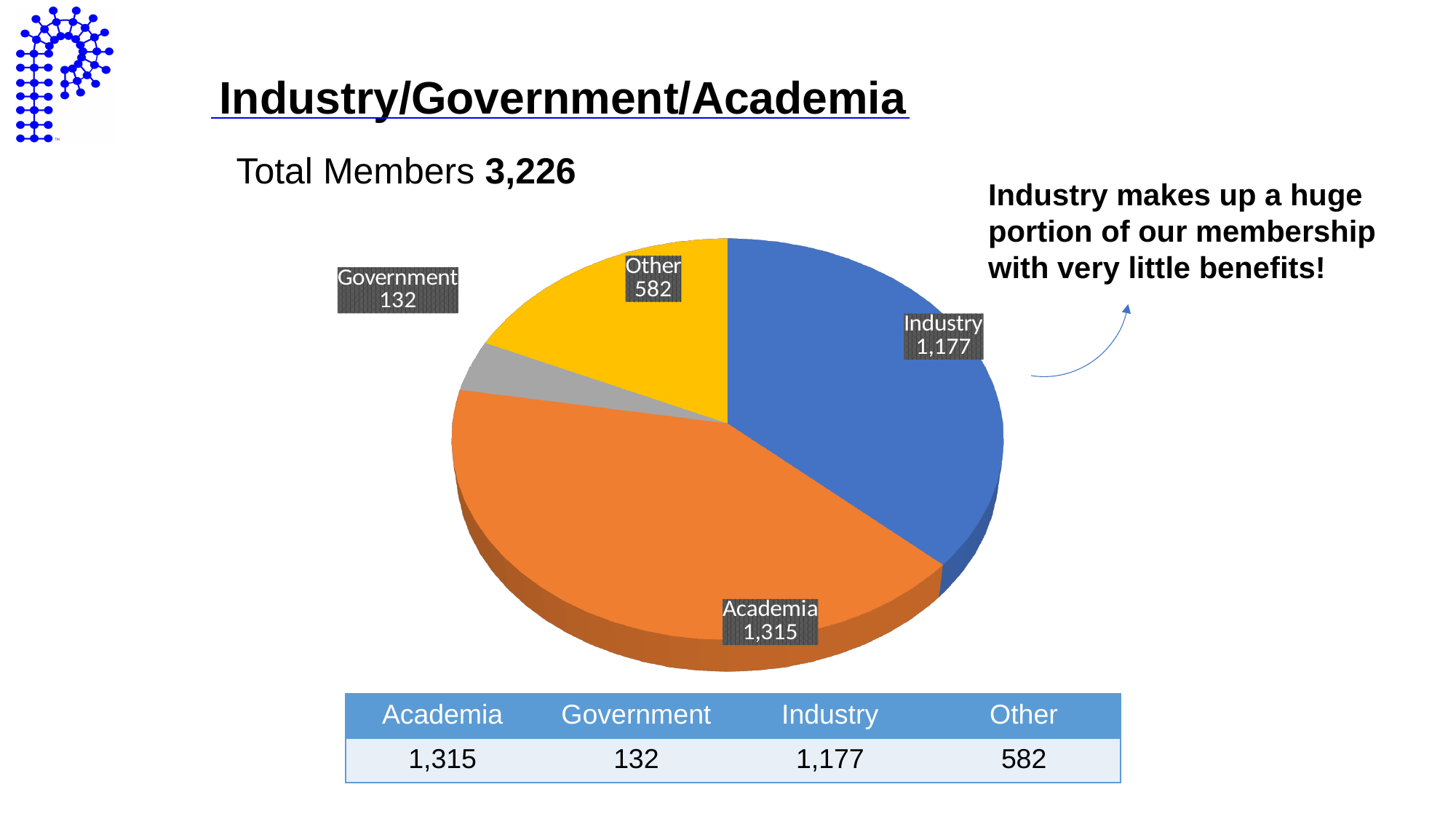
What is the value for Government in the pie chart? 132 What colour is the Academia slice in the pie chart? orange What is the value for Industry in the pie chart? 1,177 Which is larger, the value for Industry or the value for Other? Industry What is the value for Academia in the pie chart? 1,315 What is the difference between the Other and Government values? 450 Which category has the smallest slice of the pie chart? Government What is the difference between the Academia and Industry values? 138 What kind of chart is shown on the slide? pie chart What is the value for Other in the pie chart? 582 How many slices does the pie chart have? 4 Which category has the largest slice of the pie chart? Academia